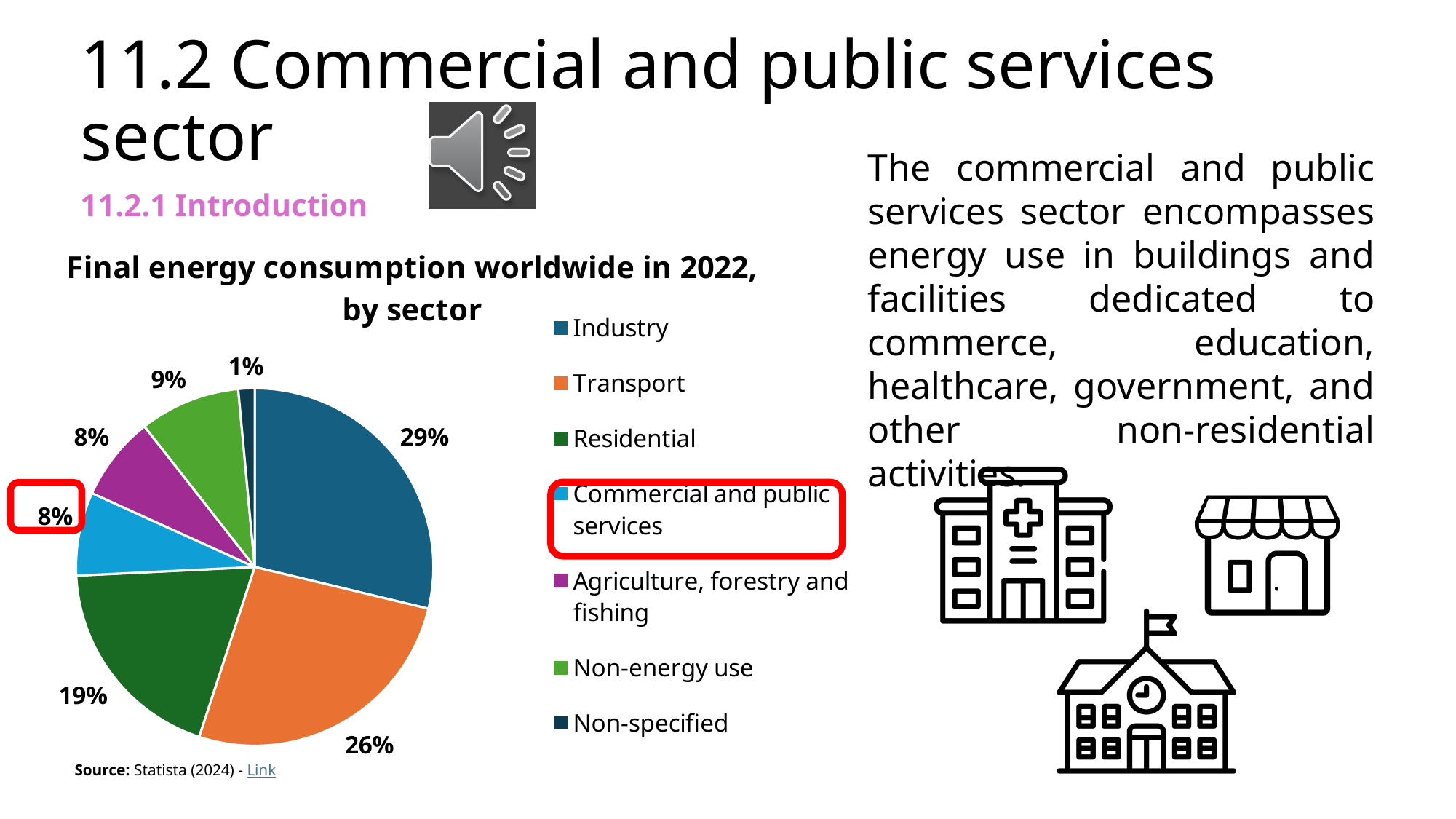
What share of final energy consumption does the Commercial and public services sector account for? 8% What share of final energy consumption does Residential account for? 19% What is the title of the chart? Final energy consumption worldwide in 2022, by sector What share of final energy consumption does Non-energy use account for? 9% What share of final energy consumption does Transport account for? 26% Which has a larger share, Residential or Non-energy use? Residential Which sector has the largest share of final energy consumption? Industry What share of final energy consumption does Industry account for? 29% What type of chart is shown on the slide? Pie chart How many sectors are listed in the chart legend? 7 What is the difference in percentage points between the Industry and Transport shares? 3 Which sector has the smallest share of final energy consumption? Non-specified